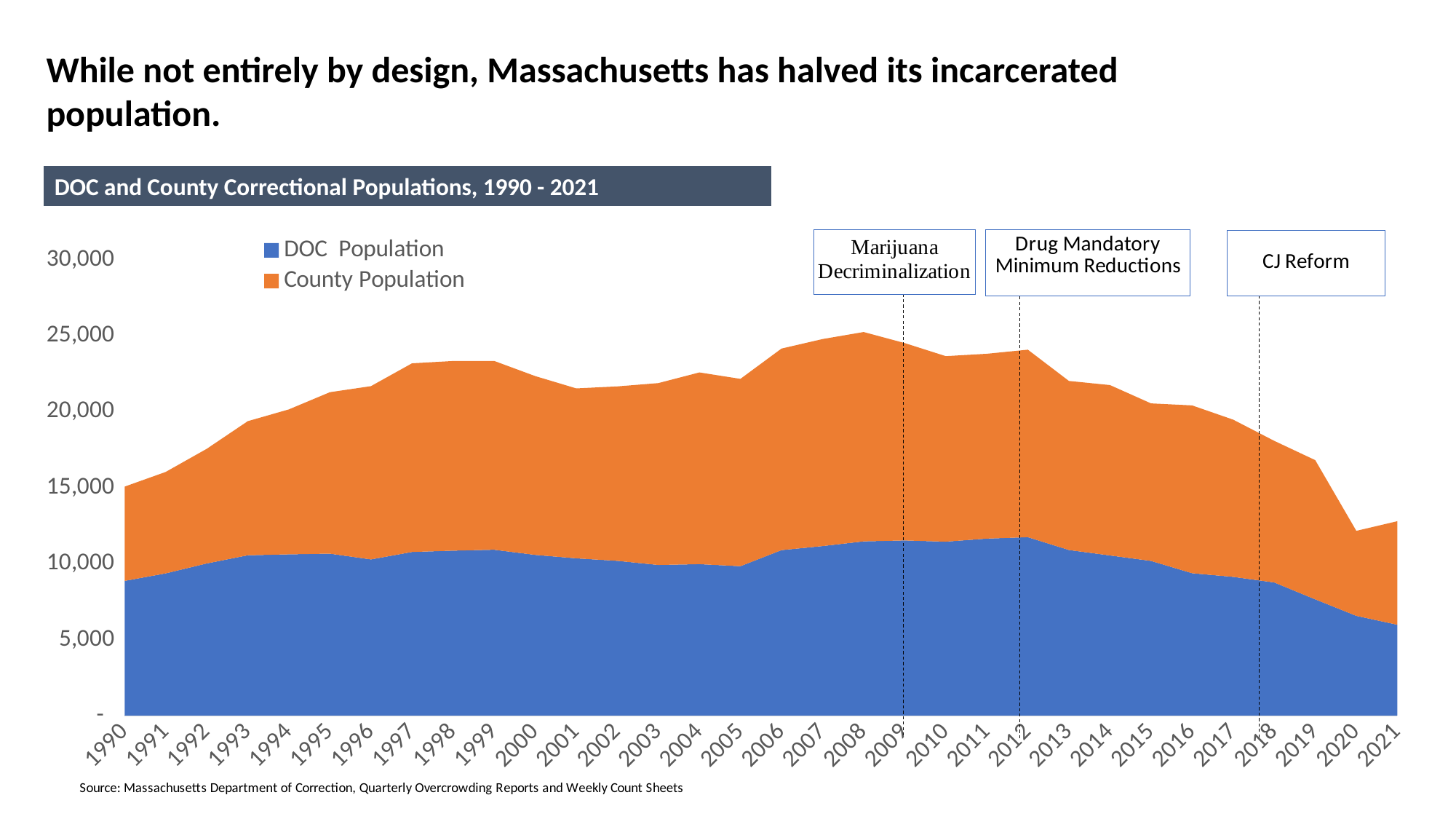
Is the DOC Population in 2012 greater or less than 10,000? greater How many series does the legend list? 2 Does the total correctional population rise or fall from 2012 to 2021? fall Which year is marked with the 'CJ Reform' annotation line? 2018 What is the title of the chart? DOC and County Correctional Populations, 1990 - 2021 In which year does the total correctional population (top of the stacked area) reach its highest point? 2008 What kind of chart is shown on the slide? Stacked area chart Is the DOC Population in 2021 greater or less than 5,000? greater Is the total correctional population (DOC plus County) in 2021 greater or less than 15,000? less How many years are shown along the x axis? 32